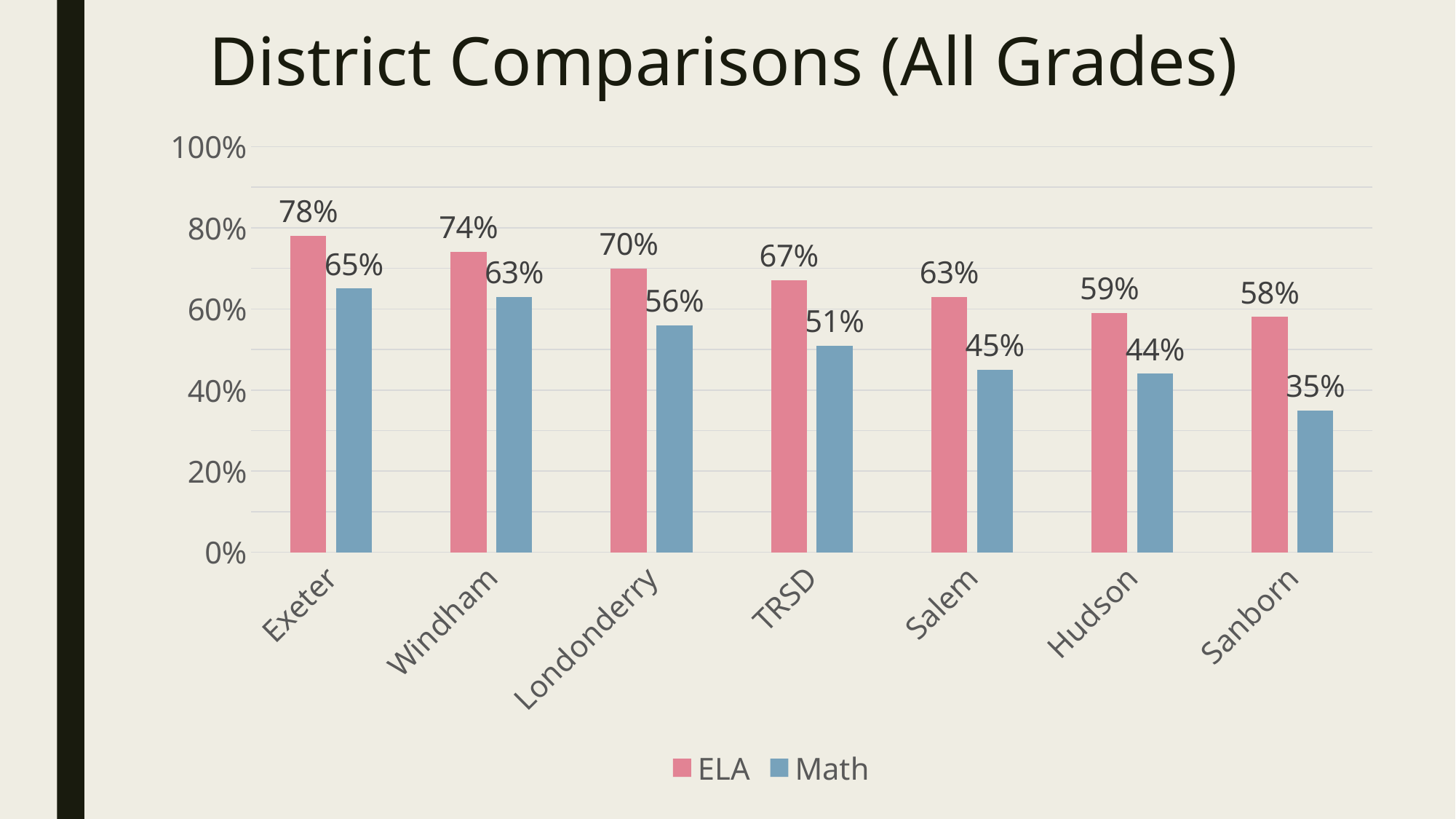
How many districts are shown on the x axis? 7 What is the Math value for Sanborn? 35% What is the difference between the ELA and Math values for TRSD? 16% How many series does the legend list? 2 Do the ELA values rise or fall from Exeter to Sanborn along the x axis? fall What is the Math value for Londonderry? 56% What is the ELA value for Exeter? 78% Which district has the highest ELA value? Exeter Is the ELA value for Hudson greater or less than 40%? greater Which is larger, the Math value for Salem or the Math value for Hudson? Salem Which district has the lowest Math value? Sanborn What kind of chart is shown on the slide? bar chart